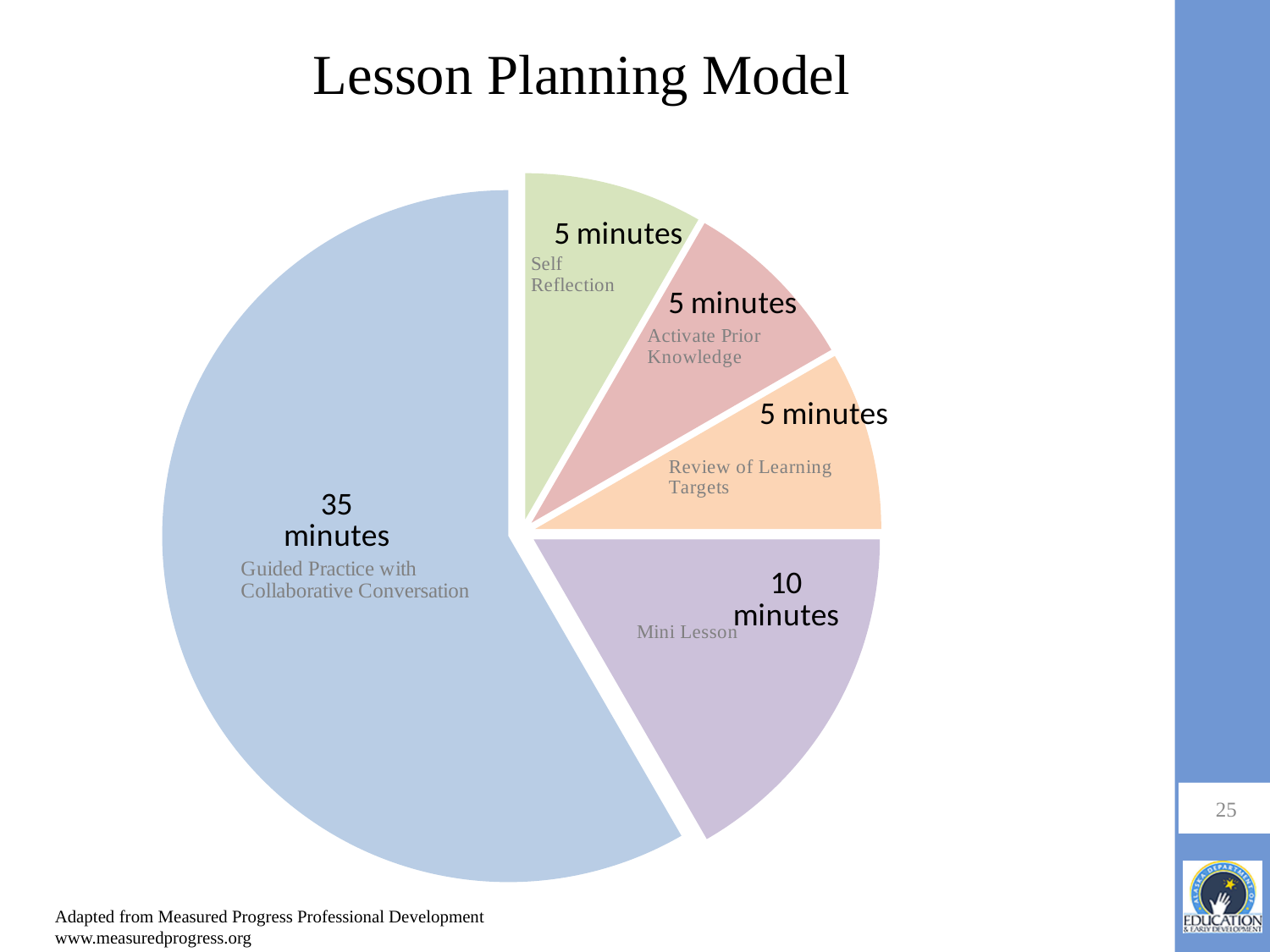
How many minutes are allotted to Self Reflection? 5 minutes How many slices does the pie chart have? 5 How many minutes are allotted to Review of Learning Targets? 5 minutes Which takes more time, the Mini Lesson or Activate Prior Knowledge? Mini Lesson Which lesson component takes the most time? Guided Practice with Collaborative Conversation How many lesson components are allotted 5 minutes each? 3 How many more minutes does Guided Practice with Collaborative Conversation take than the Mini Lesson? 25 minutes How many minutes are allotted to the Mini Lesson? 10 minutes What kind of chart is shown on the slide? Pie chart What is the title of the chart? Lesson Planning Model How many minutes are allotted to Guided Practice with Collaborative Conversation? 35 minutes What is the total number of minutes across all slices of the pie? 60 minutes